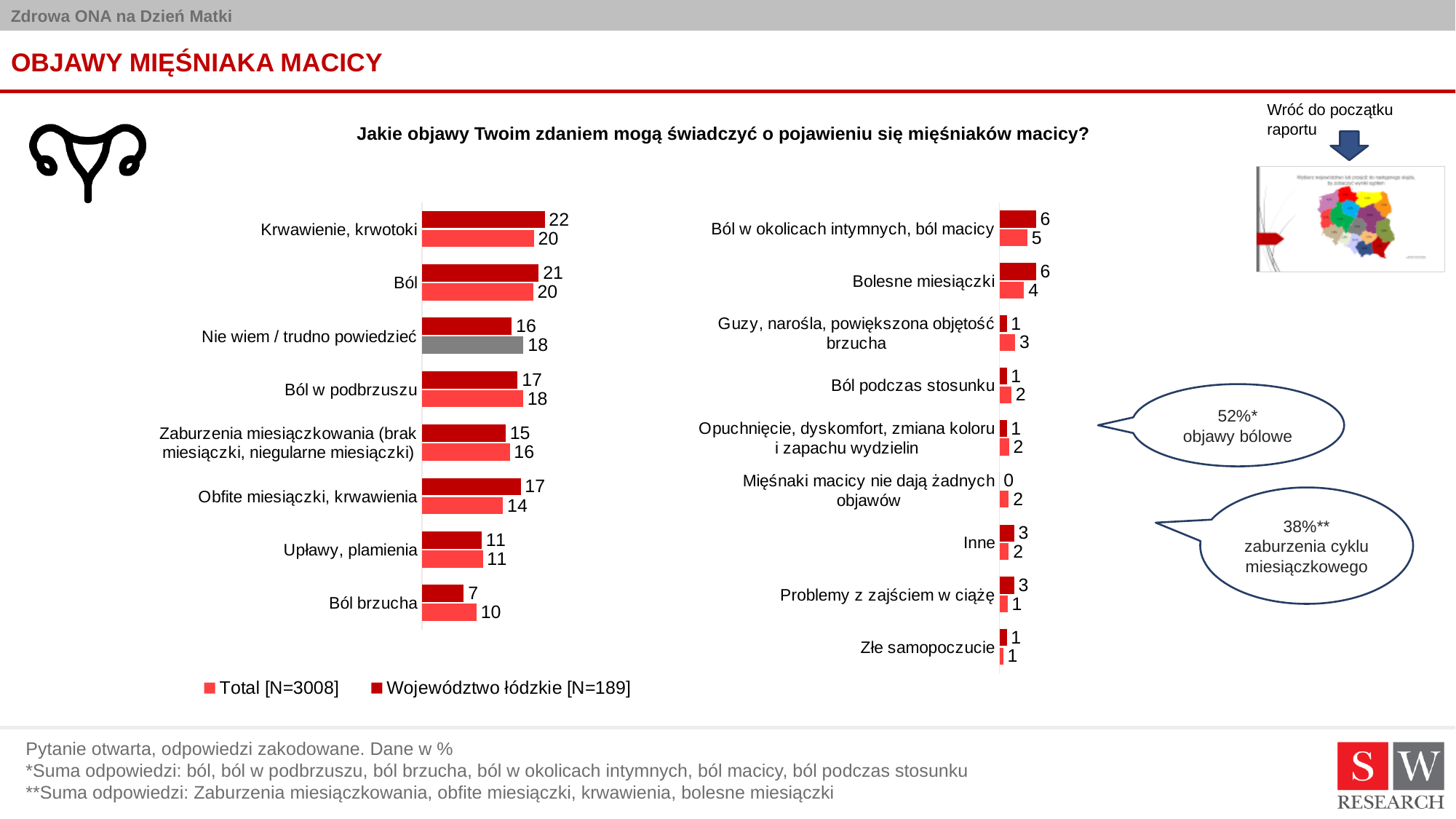
In the left chart, which category has the highest value for Województwo łódzkie [N=189]? Krwawienie, krwotoki In the left chart, what is the difference between the Województwo łódzkie and Total values for 'Obfite miesiączki, krwawienia'? 3 What type of chart is used on this slide? Bar chart In the right chart, what is the value for Total [N=3008] for 'Bolesne miesiączki'? 4 In the left chart, what is the value for Województwo łódzkie [N=189] for 'Ból brzucha'? 7 How many series does the legend list? 2 How many categories are shown in the right chart? 9 How many categories are shown in the left chart? 8 In the right chart, what is the Województwo łódzkie [N=189] value for 'Mięśniaki macicy nie dają żadnych objawów'? 0 In the right chart, which is larger for 'Guzy, narośla, powiększona objętość brzucha': the Total value or the Województwo łódzkie value? Total [N=3008] In the left chart, what is the value for Total [N=3008] for 'Krwawienie, krwotoki'? 20 In the left chart, which category has the lowest value for Total [N=3008]? Ból brzucha